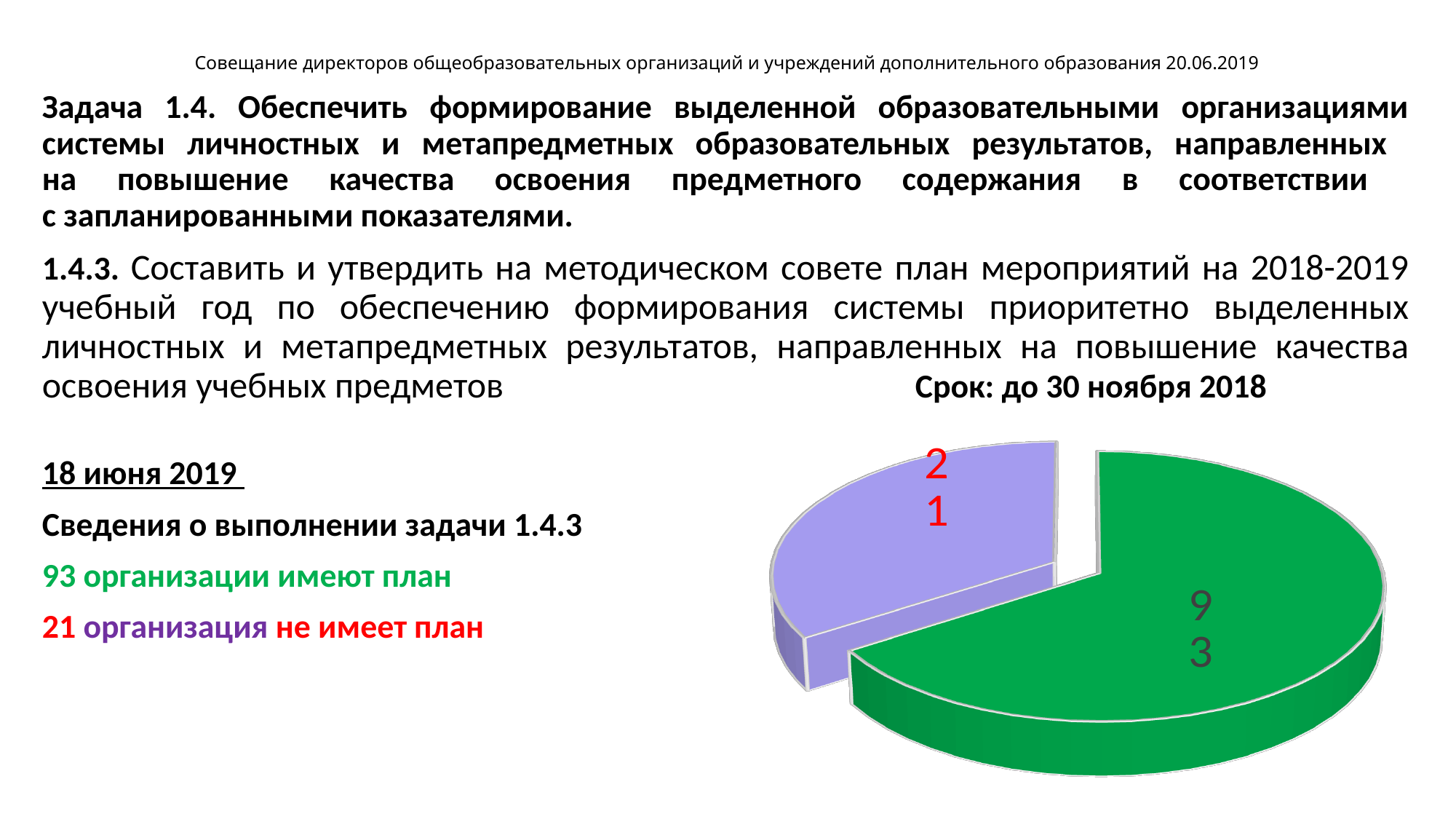
What value is shown on the purple slice of the pie chart? 21 Which is larger: the number of organizations with a plan or without a plan? with a plan (93) Which slice of the pie chart is the largest? the green slice (93) How many slices does the pie chart have? 2 What kind of chart is shown on the slide? pie chart What value is shown on the green slice of the pie chart? 93 What is the difference between the two values shown on the pie chart? 72 Which slice of the pie chart is the smallest? the purple slice (21) What is the total of the two values shown on the pie chart? 114 How many organizations have a plan (имеют план) according to the pie chart? 93 How many organizations do not have a plan (не имеет план) according to the pie chart? 21 What colour is the slice representing organizations without a plan? purple